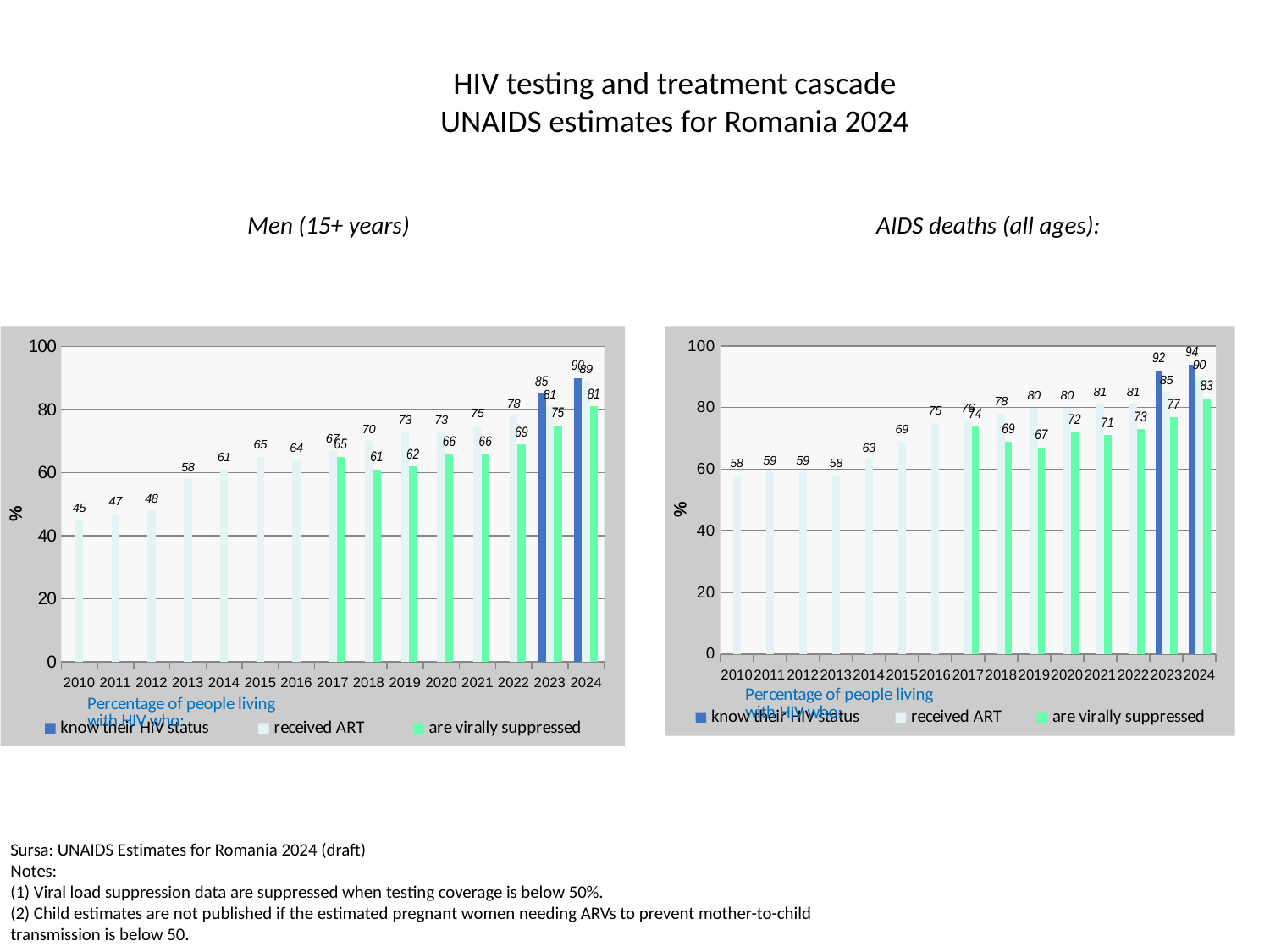
In the Men (15+ years) chart, what percentage received ART in 2010? 45 In the Men (15+ years) chart, does the received ART percentage generally rise or fall from 2010 to 2024? rise In the AIDS deaths (all ages) chart, what percentage were virally suppressed in 2019? 67 How many series does the legend of the Men (15+ years) chart list? 3 In the Men (15+ years) chart, what percentage were virally suppressed in 2018? 61 In the Men (15+ years) chart, what is the difference between the percentage who knew their HIV status and the percentage virally suppressed in 2023? 10 In the AIDS deaths (all ages) chart, which is larger in 2017: received ART or virally suppressed? received ART What type of chart is the AIDS deaths (all ages) chart? bar chart In the Men (15+ years) chart, what percentage knew their HIV status in 2024? 90 In the AIDS deaths (all ages) chart, what is the difference between received ART in 2024 and received ART in 2010? 32 In the AIDS deaths (all ages) chart, what percentage knew their HIV status in 2024? 94 In the Men (15+ years) chart, which year has the lowest value for received ART? 2010